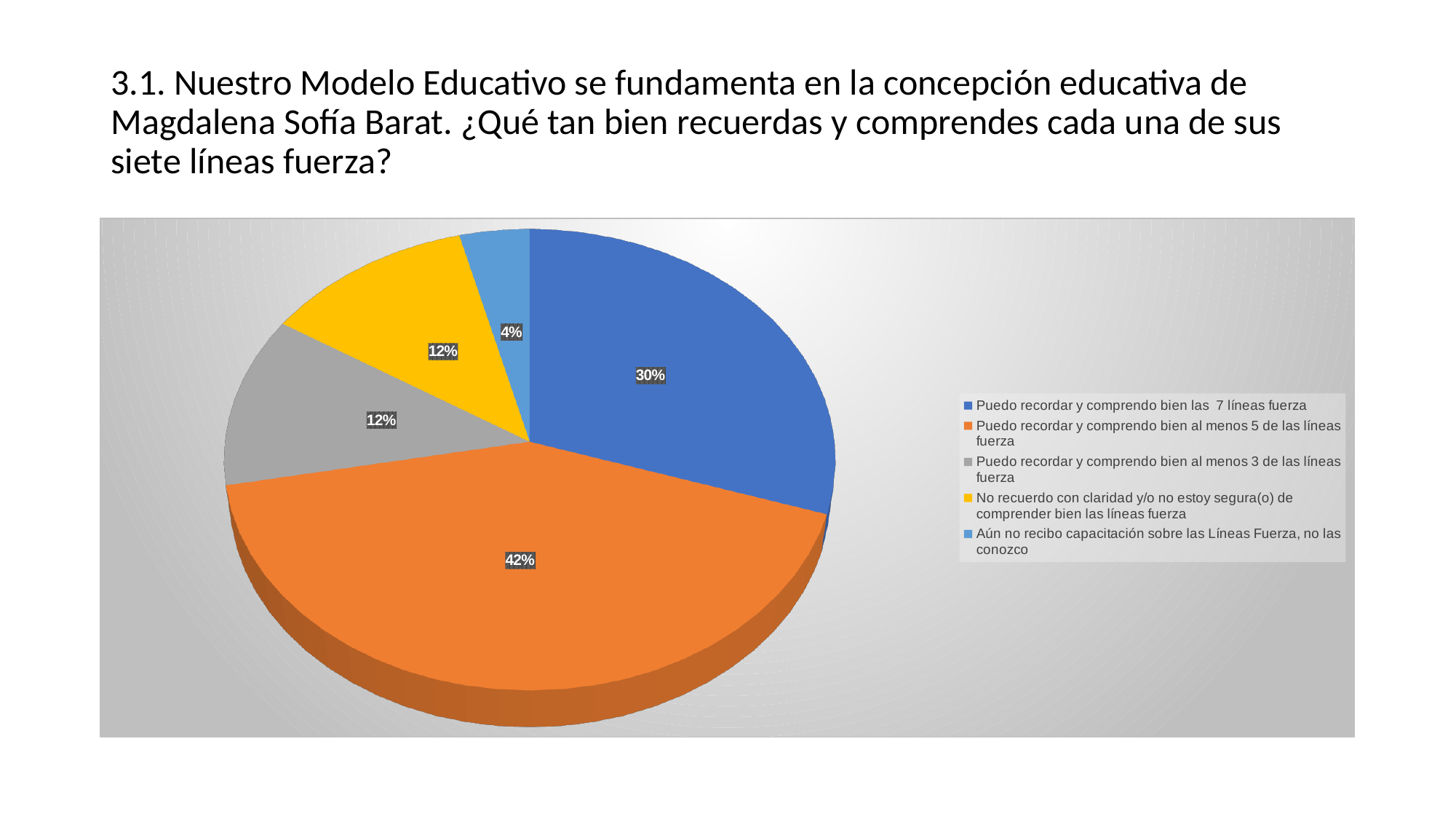
What percentage of respondents said 'Aún no recibo capacitación sobre las Líneas Fuerza, no las conozco'? 4% Which response category has the smallest share of the pie? Aún no recibo capacitación sobre las Líneas Fuerza, no las conozco Which is larger: the share for 'Puedo recordar y comprendo bien las 7 líneas fuerza' or the share for 'No recuerdo con claridad y/o no estoy segura(o) de comprender bien las líneas fuerza'? Puedo recordar y comprendo bien las 7 líneas fuerza What kind of chart is shown on the slide? Pie chart What is the difference in percentage points between 'Puedo recordar y comprendo bien al menos 5 de las líneas fuerza' and 'Puedo recordar y comprendo bien las 7 líneas fuerza'? 12 What colour is the slice for 'No recuerdo con claridad y/o no estoy segura(o) de comprender bien las líneas fuerza'? Yellow What percentage of respondents said 'Puedo recordar y comprendo bien al menos 5 de las líneas fuerza'? 42% What colour is the slice for 'Puedo recordar y comprendo bien al menos 5 de las líneas fuerza'? Orange What percentage of respondents said 'Puedo recordar y comprendo bien al menos 3 de las líneas fuerza'? 12% What percentage of respondents said 'Puedo recordar y comprendo bien las 7 líneas fuerza'? 30% How many categories does the pie chart have? 5 Which response category has the largest share of the pie? Puedo recordar y comprendo bien al menos 5 de las líneas fuerza